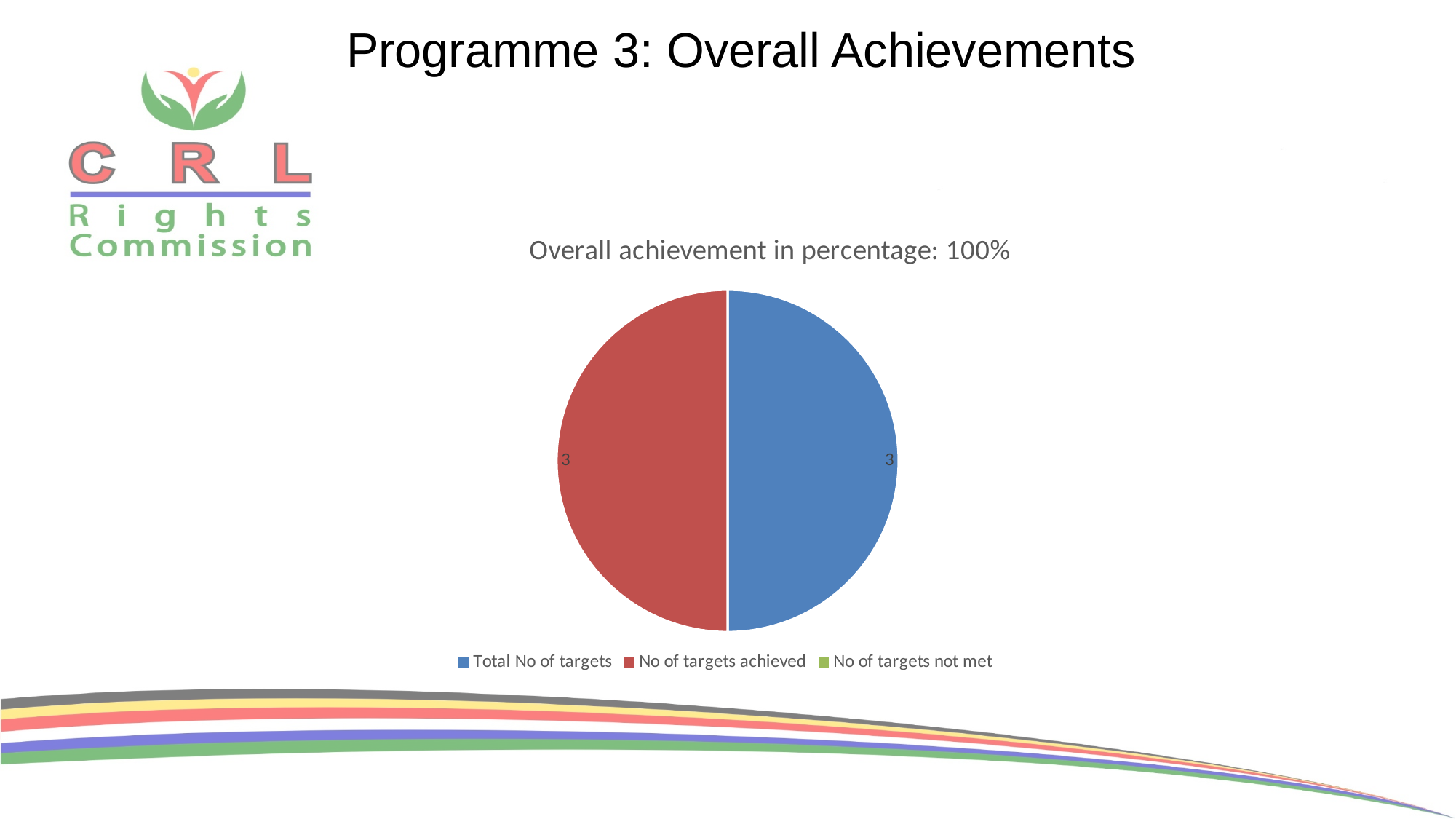
What colour is the slice for No of targets achieved? Red What is the difference between the value for Total No of targets and the value for No of targets achieved? 0 What share of the pie does the Total No of targets slice take up? 50% What is the value shown for Total No of targets? 3 How many slices with data labels are visible in the pie? 2 Which is larger, the value for Total No of targets or the value for No of targets achieved? They are equal What is the title of the chart? Overall achievement in percentage: 100% What is the value shown for No of targets achieved? 3 What kind of chart is shown on the slide? Pie chart How many entries does the legend list? 3